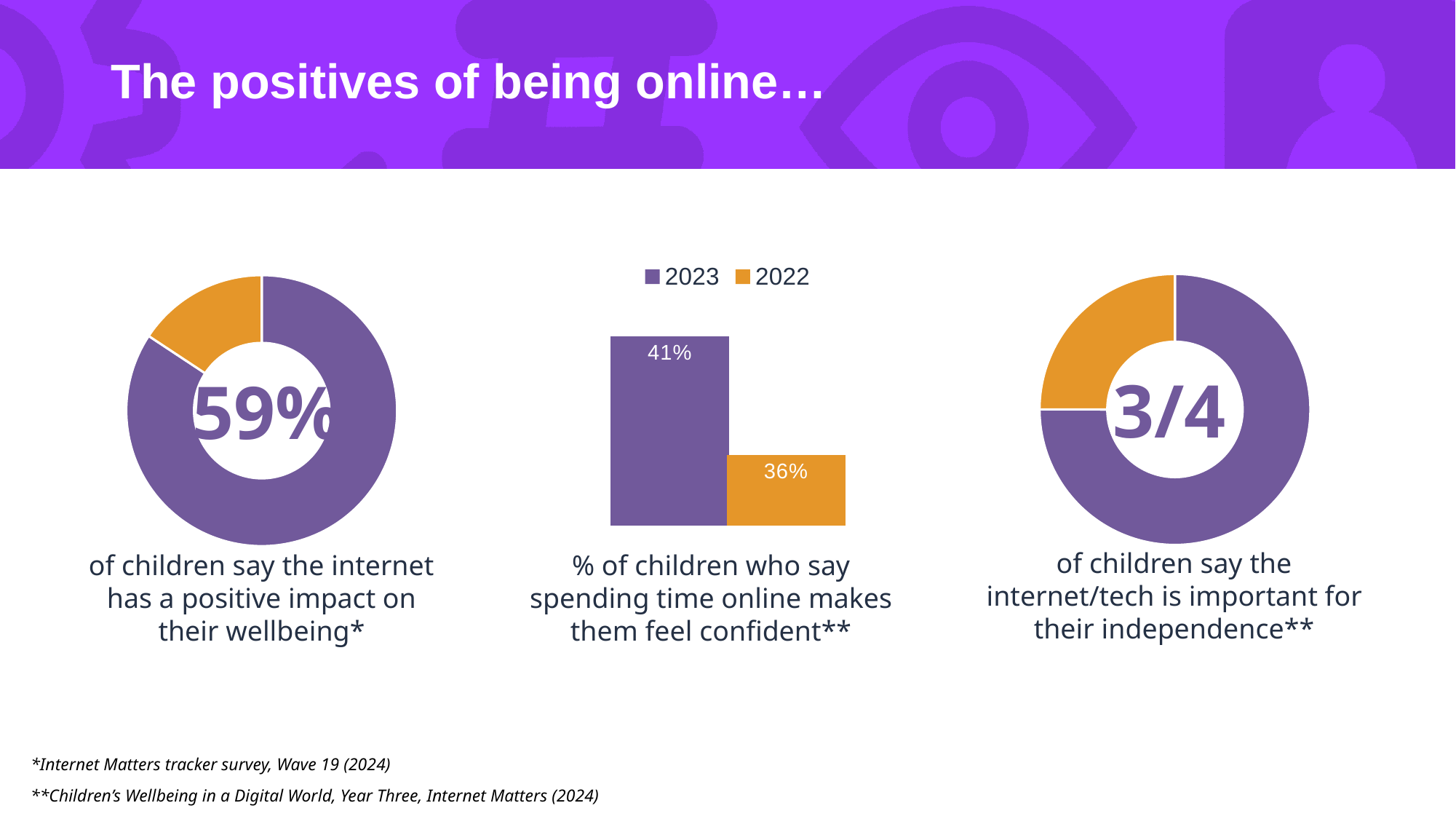
In the right-hand donut chart, what fraction of children say the internet/tech is important for their independence? 3/4 In the left-hand donut chart, what percentage of children say the internet has a positive impact on their wellbeing? 59% What kind of chart is the left-hand chart showing 59%? Donut (pie) chart In the middle bar chart, what percentage of children said spending time online makes them feel confident in 2022? 36% In the left-hand donut chart, which colour is the larger slice? Purple In the middle bar chart, what is the difference between the 2023 and 2022 values? 5 percentage points How many series does the legend of the middle chart list? 2 In the middle bar chart, which colour does the legend assign to 2022? Orange In the middle bar chart, which year has the higher value, 2023 or 2022? 2023 What kind of chart is the middle chart about children feeling confident online? Bar chart In the middle bar chart, what percentage of children said spending time online makes them feel confident in 2023? 41% How many bars are plotted in the middle bar chart? 2